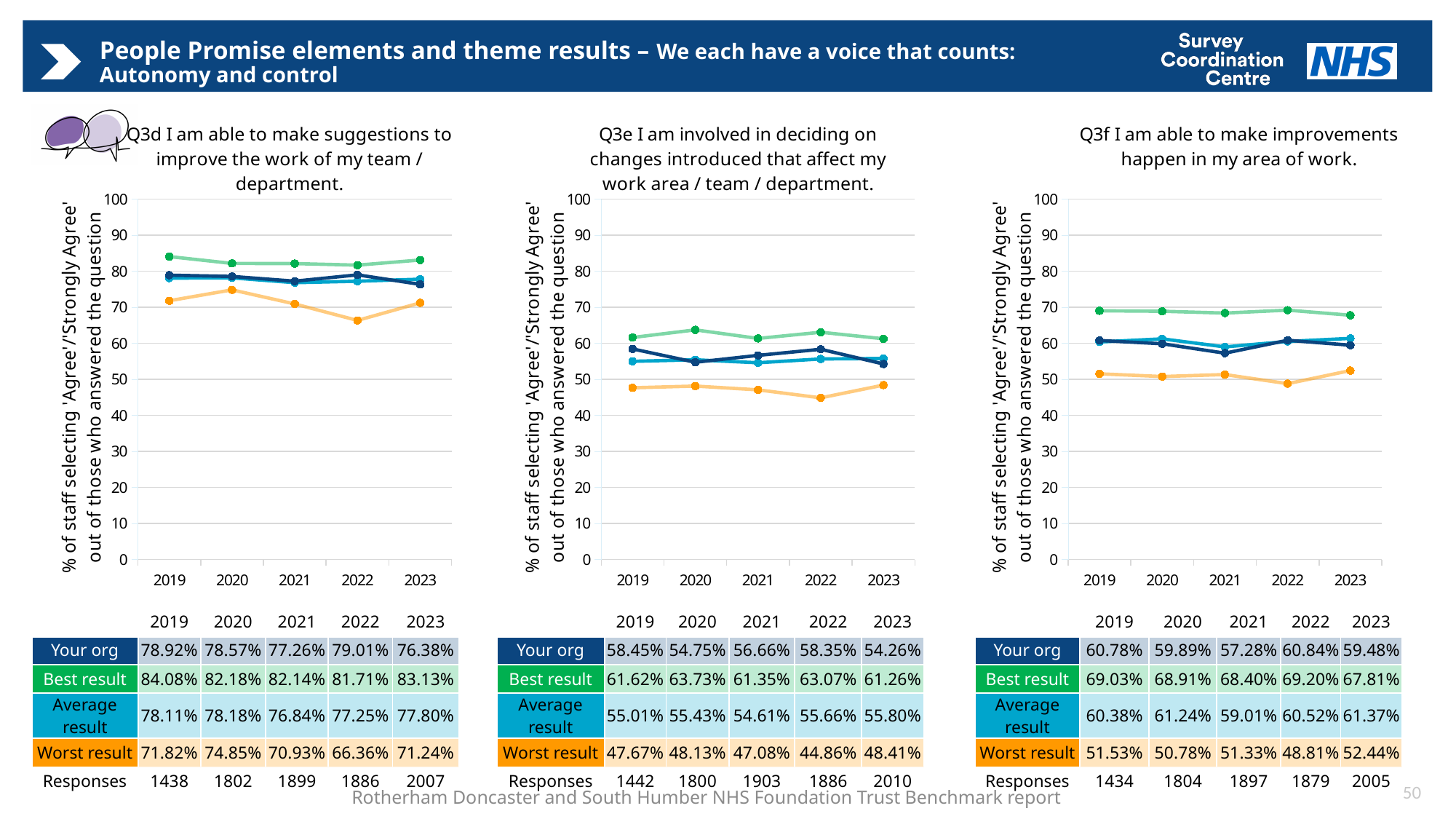
How many series are plotted in the Q3d chart? 4 In the Q3e chart (I am involved in deciding on changes introduced that affect my work area / team / department), what is the 'Best result' value for 2020? 63.73% In the Q3d chart, is the 'Your org' value for 2022 larger or smaller than the 'Average result' value for 2022? larger In the Q3f chart, what is the difference between the 'Best result' and 'Your org' values for 2019? 8.25% In the Q3d chart (I am able to make suggestions to improve the work of my team / department), what is the 'Your org' value for 2023? 76.38% In the Q3f chart (I am able to make improvements happen in my area of work), what is the 'Worst result' value for 2022? 48.81% In the Q3e chart, which year has the highest 'Your org' value? 2019 In the Q3d chart, how many responses were recorded for 2023? 2007 In the Q3d chart, which year has the lowest 'Worst result' value? 2022 What type of chart is used for Q3e? Line chart In the Q3e chart, is the 'Worst result' value for 2022 greater or less than 50? less How many years are plotted on the x axis of the Q3f chart? 5